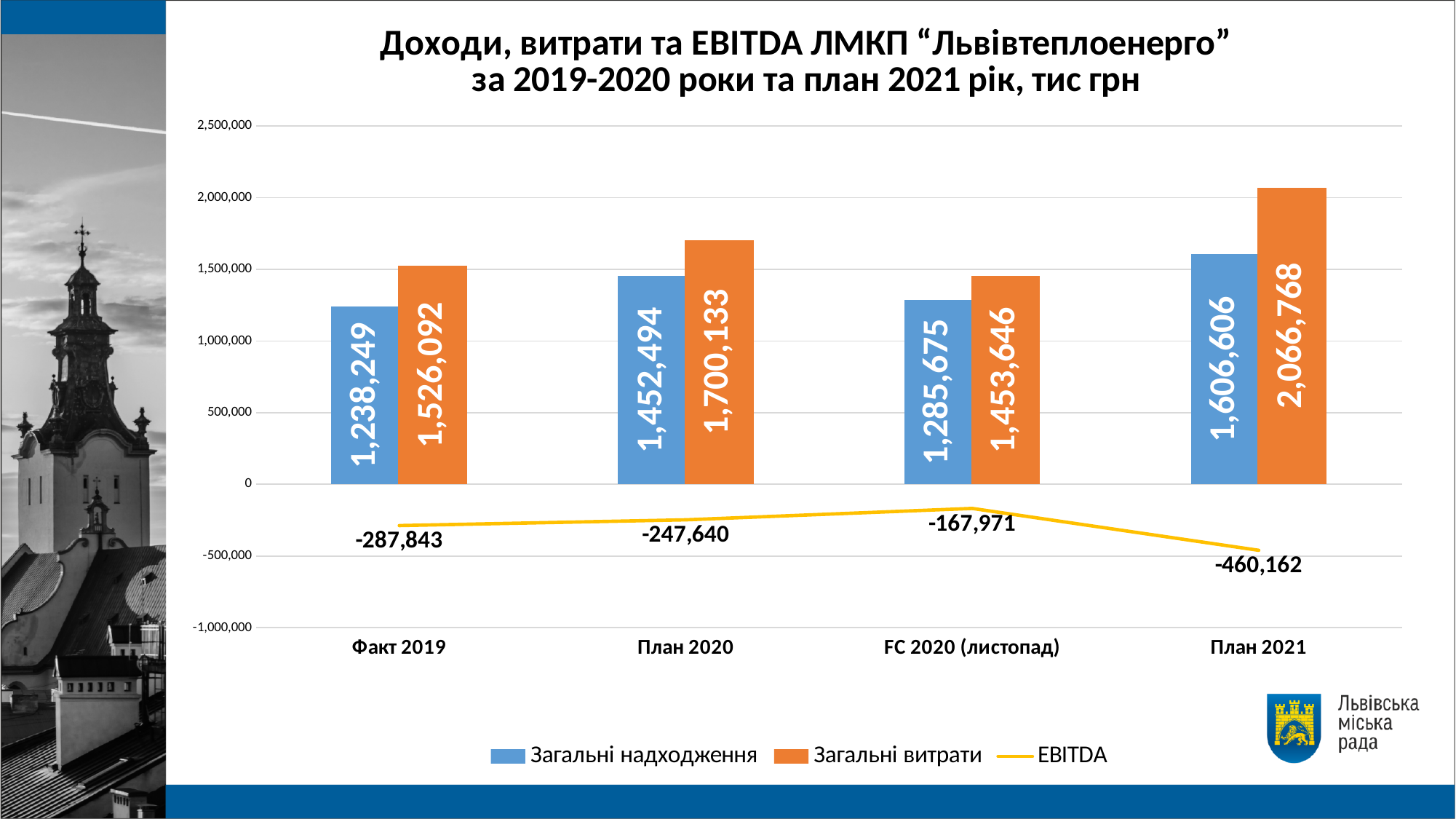
Which category has the highest Загальні витрати? План 2021 Which is larger for FC 2020 (листопад): Загальні надходження or Загальні витрати? Загальні витрати Which category has the lowest EBITDA value? План 2021 What is the EBITDA value for FC 2020 (листопад)? -167,971 How many categories are shown on the x axis? 4 What is the difference between Загальні витрати and Загальні надходження for План 2020? 247,639 What is the value of Загальні витрати for План 2021? 2,066,768 Which series is shown as a yellow line? EBITDA What kind of chart is used to show Загальні надходження and Загальні витрати? Bar chart Is the Загальні витрати value for План 2021 greater or less than 2,000,000? greater What is the value of Загальні надходження for Факт 2019? 1,238,249 How many series does the legend list? 3